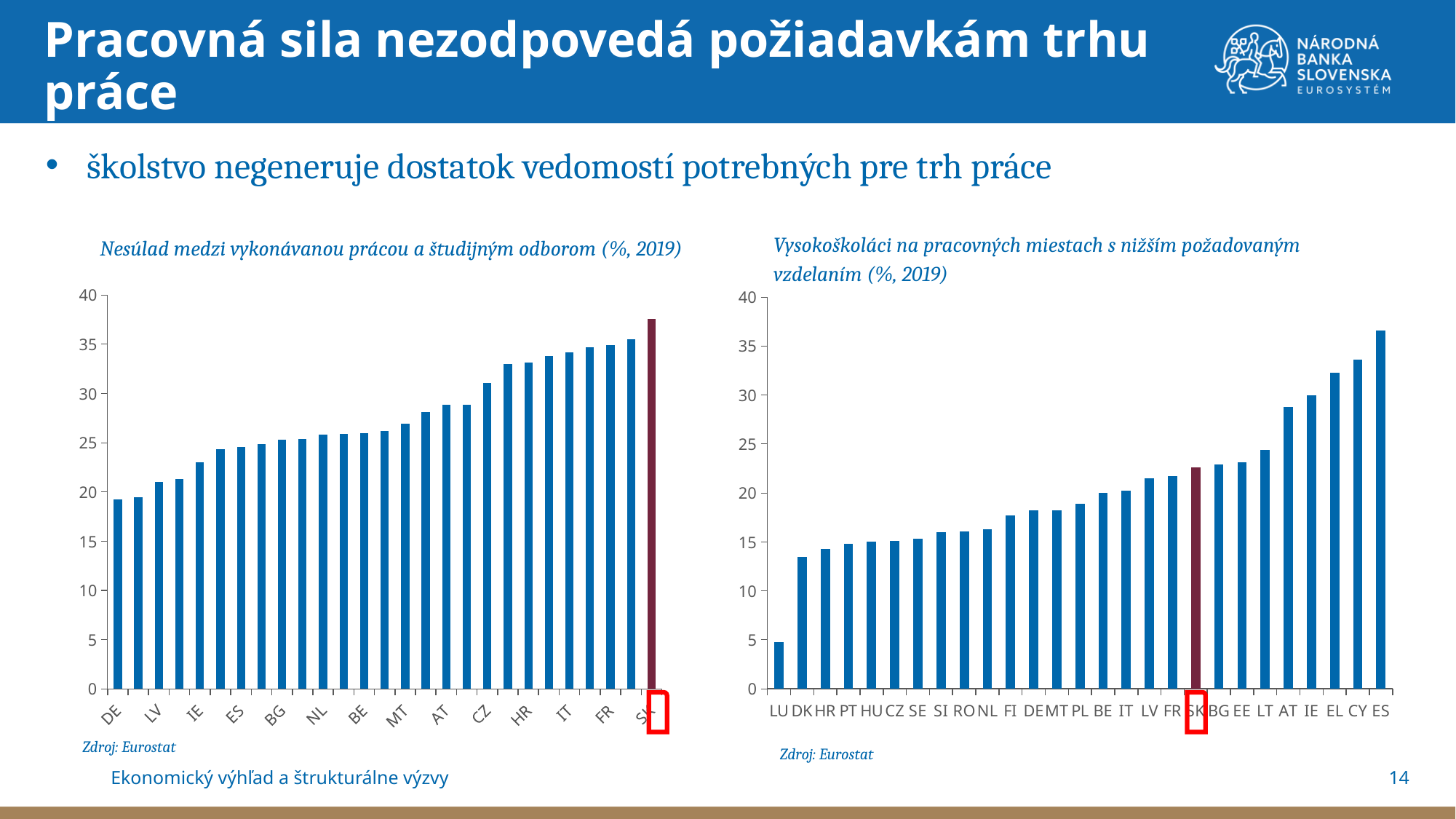
How many countries are shown on the x axis of the right chart (Vysokoškoláci na pracovných miestach s nižším požadovaným vzdelaním)? 27 In the left chart (Nesúlad medzi vykonávanou prácou a študijným odborom), is the value for DE greater or less than 20? less In the right chart (Vysokoškoláci na pracovných miestach s nižším požadovaným vzdelaním), is the value for SK greater or less than 20? greater In the right chart (Vysokoškoláci na pracovných miestach s nižším požadovaným vzdelaním), which country has the lowest value? LU What kind of chart is the left chart titled 'Nesúlad medzi vykonávanou prácou a študijným odborom (%, 2019)'? bar chart In the right chart (Vysokoškoláci na pracovných miestach s nižším požadovaným vzdelaním), which country has the highest value? ES In the right chart (Vysokoškoláci na pracovných miestach s nižším požadovaným vzdelaním), which is larger, the value for CY or the value for DK? CY In the left chart (Nesúlad medzi vykonávanou prácou a študijným odborom), which country has the highest value? SK In the left chart (Nesúlad medzi vykonávanou prácou a študijným odborom), which country has the lowest value? DE In the left chart (Nesúlad medzi vykonávanou prácou a študijným odborom), is the value for SK greater or less than 35? greater In the left chart (Nesúlad medzi vykonávanou prácou a študijným odborom), do the values rise or fall from left to right along the x axis? rise